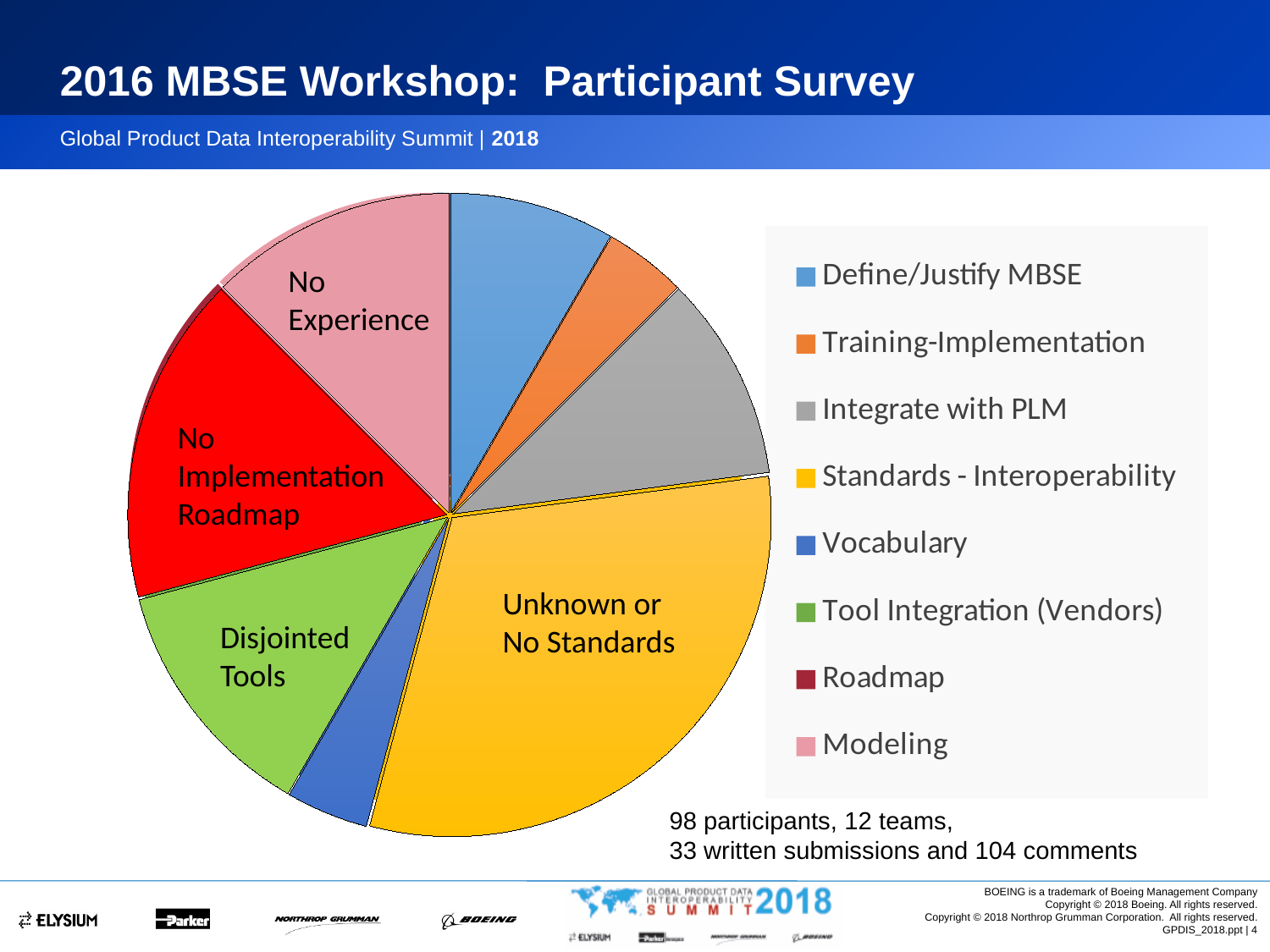
What colour is the Modeling slice in the pie chart? Pink Which slice is larger, Modeling or Define/Justify MBSE? Modeling Which slice is larger, Vocabulary or Roadmap? Roadmap Which category has the largest slice of the pie chart? Standards - Interoperability Which slice is larger, Tool Integration (Vendors) or Vocabulary? Tool Integration (Vendors) What kind of chart is shown on the slide? Pie chart How many entries does the legend of the pie chart list? 8 How many slices does the pie chart have? 8 Which legend category does the slice annotated "Unknown or No Standards" belong to? Standards - Interoperability